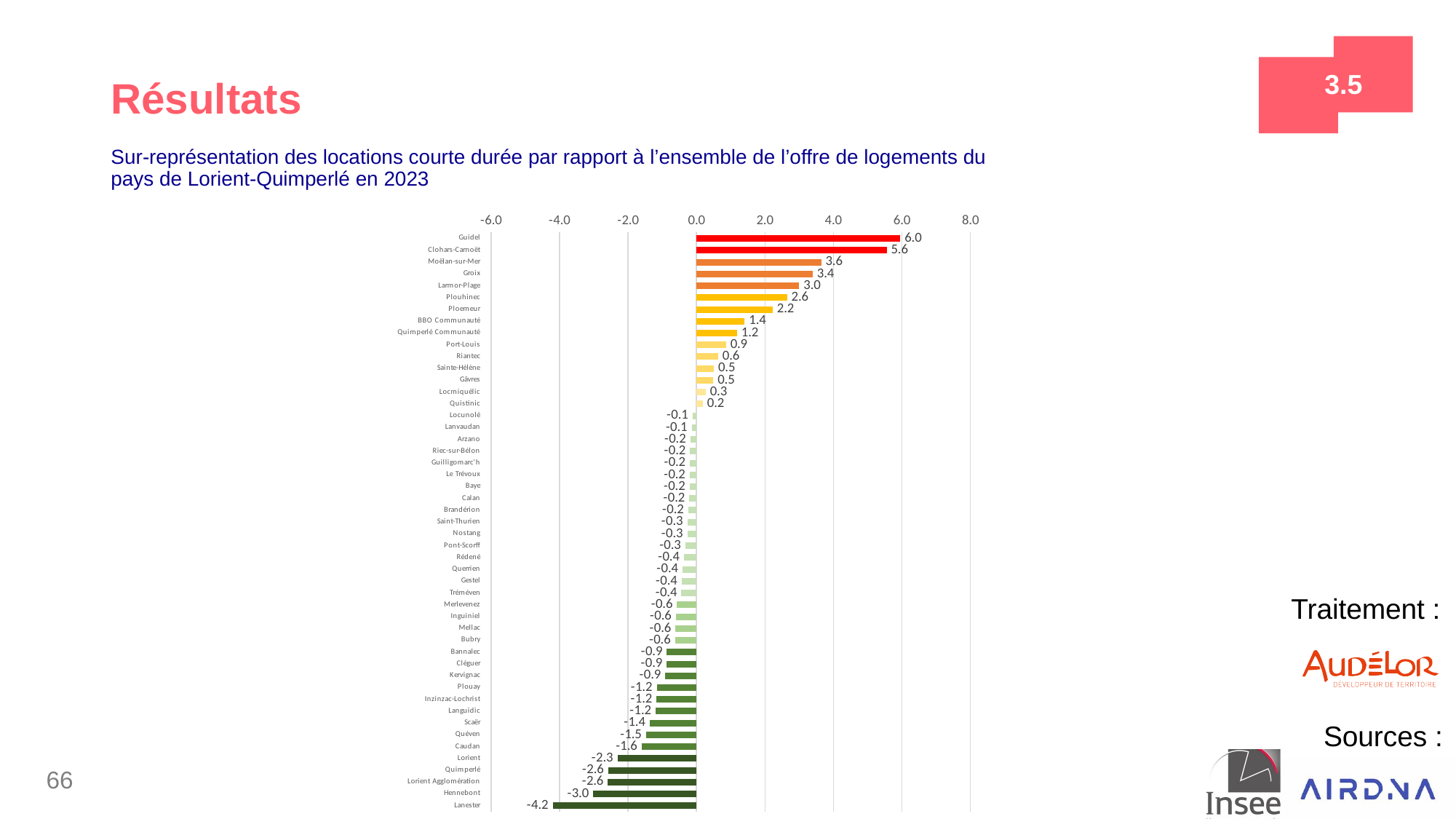
What is the value for Guidel? 6.0 What is the value for Lanester? -4.2 Which category has the highest value? Guidel Is the value for Lorient greater or less than -2.0? less What is the value for Groix? 3.4 What year does the chart's title refer to? 2023 Which category has the lowest value? Lanester What is the difference between the values for Guidel and Clohars-Carnoët? 0.4 What is the value for Hennebont? -3.0 Which has a larger value, Moëlan-sur-Mer or Groix? Moëlan-sur-Mer Is the value for Larmor-Plage greater or less than 2.0? greater What kind of chart is shown on the slide? bar chart